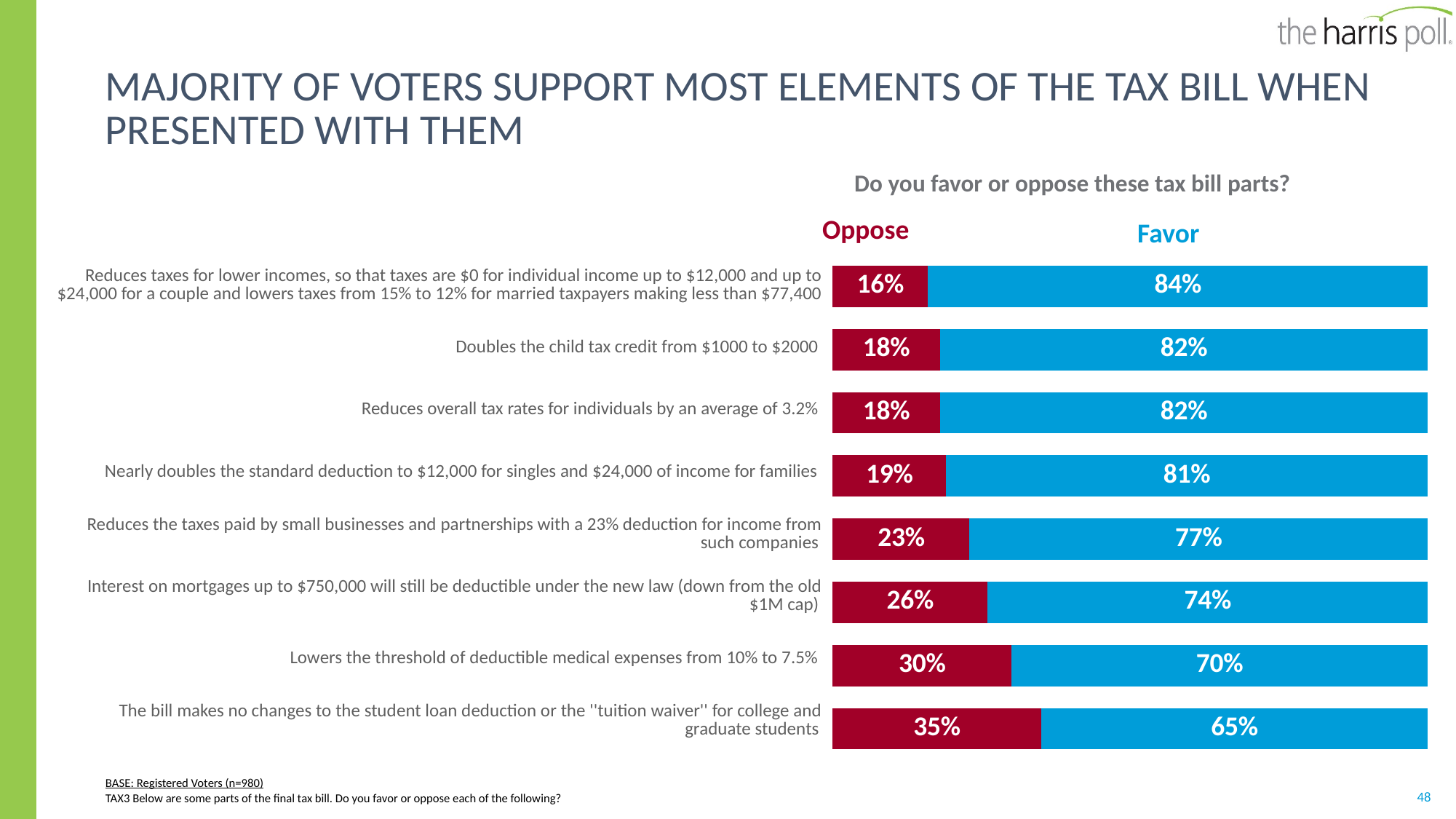
Which has a higher Oppose percentage: the mortgage interest deduction item or the medical expenses threshold item? Lowers the threshold of deductible medical expenses from 10% to 7.5% What is the difference between the Favor and Oppose percentages for the small businesses and partnerships 23% deduction item? 54 percentage points How many series does the chart show? 2 How many tax bill parts are shown in the chart? 8 Which tax bill part has the highest Favor percentage? Reduces taxes for lower incomes, so that taxes are $0 for individual income up to $12,000 and up to $24,000 for a couple and lowers taxes from 15% to 12% for married taxpayers making less than $77,400 What is the Favor value for 'Interest on mortgages up to $750,000 will still be deductible under the new law'? 74% What percentage of voters oppose the item 'Lowers the threshold of deductible medical expenses from 10% to 7.5%'? 30% Which tax bill part has the lowest Favor percentage? The bill makes no changes to the student loan deduction or the ''tuition waiver'' for college and graduate students What is the total of the Oppose and Favor values for the standard deduction item? 100% What percentage of voters favor doubling the child tax credit from $1000 to $2000? 82% What type of chart is shown on the slide? Stacked bar chart Which tax bill part has the highest Oppose percentage? The bill makes no changes to the student loan deduction or the ''tuition waiver'' for college and graduate students